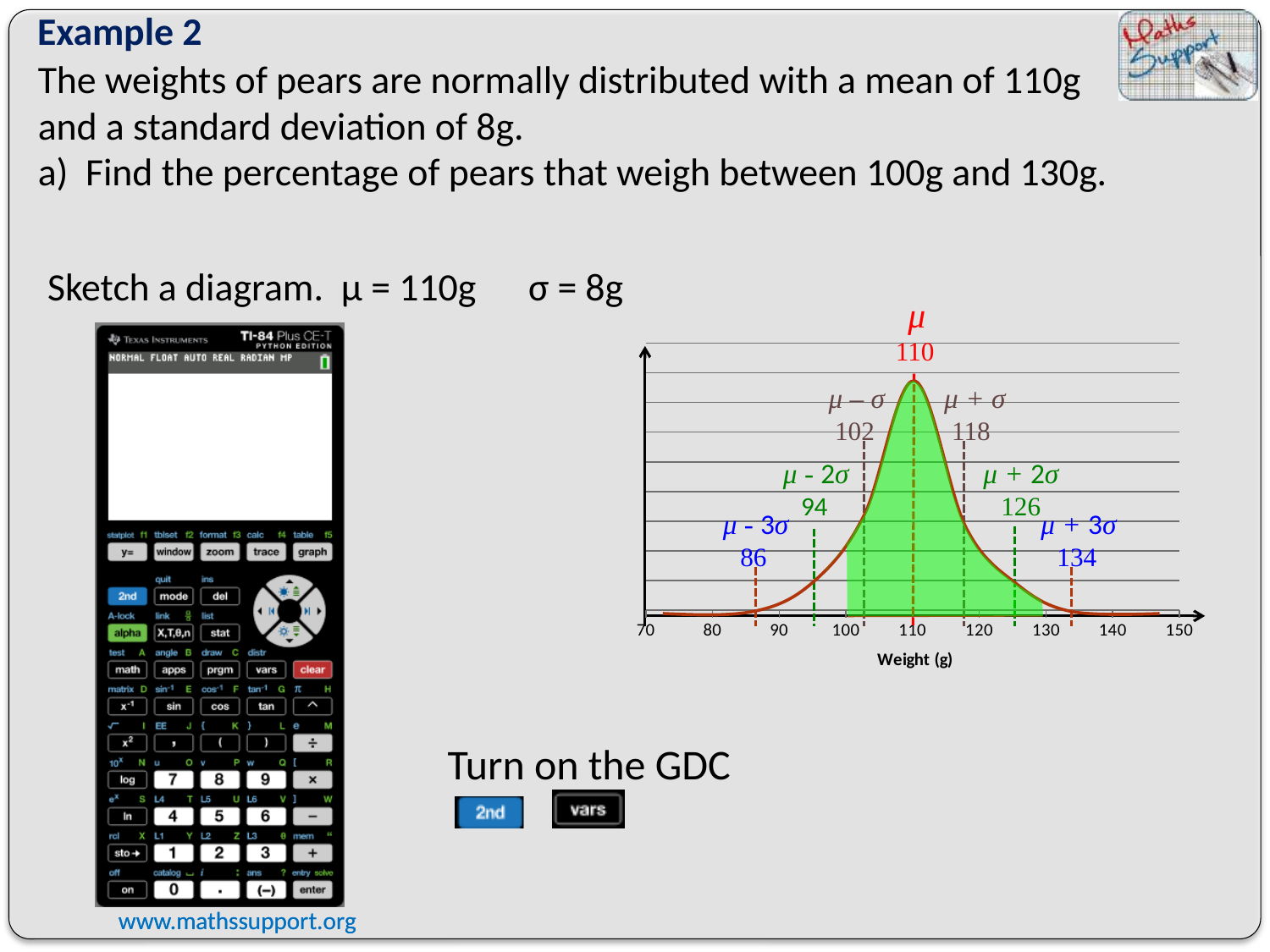
What is the lowest tick value shown on the horizontal axis of the diagram? 70 What value is marked at μ + 3σ on the diagram? 134 What value is marked at μ + 2σ on the diagram? 126 What is the difference between the values marked at μ + σ and μ − σ on the diagram? 16 What value is marked at μ − 3σ on the diagram? 86 What value is marked at μ on the normal distribution diagram? 110 What value is marked at μ − 2σ on the diagram? 94 What value is marked at μ − σ on the diagram? 102 Between which two weights on the horizontal axis is the region under the curve shaded green? 100 and 130 What is the label on the horizontal axis of the normal distribution diagram? Weight (g) What value is marked at μ + σ on the diagram? 118 What is the highest tick value shown on the horizontal axis of the diagram? 150